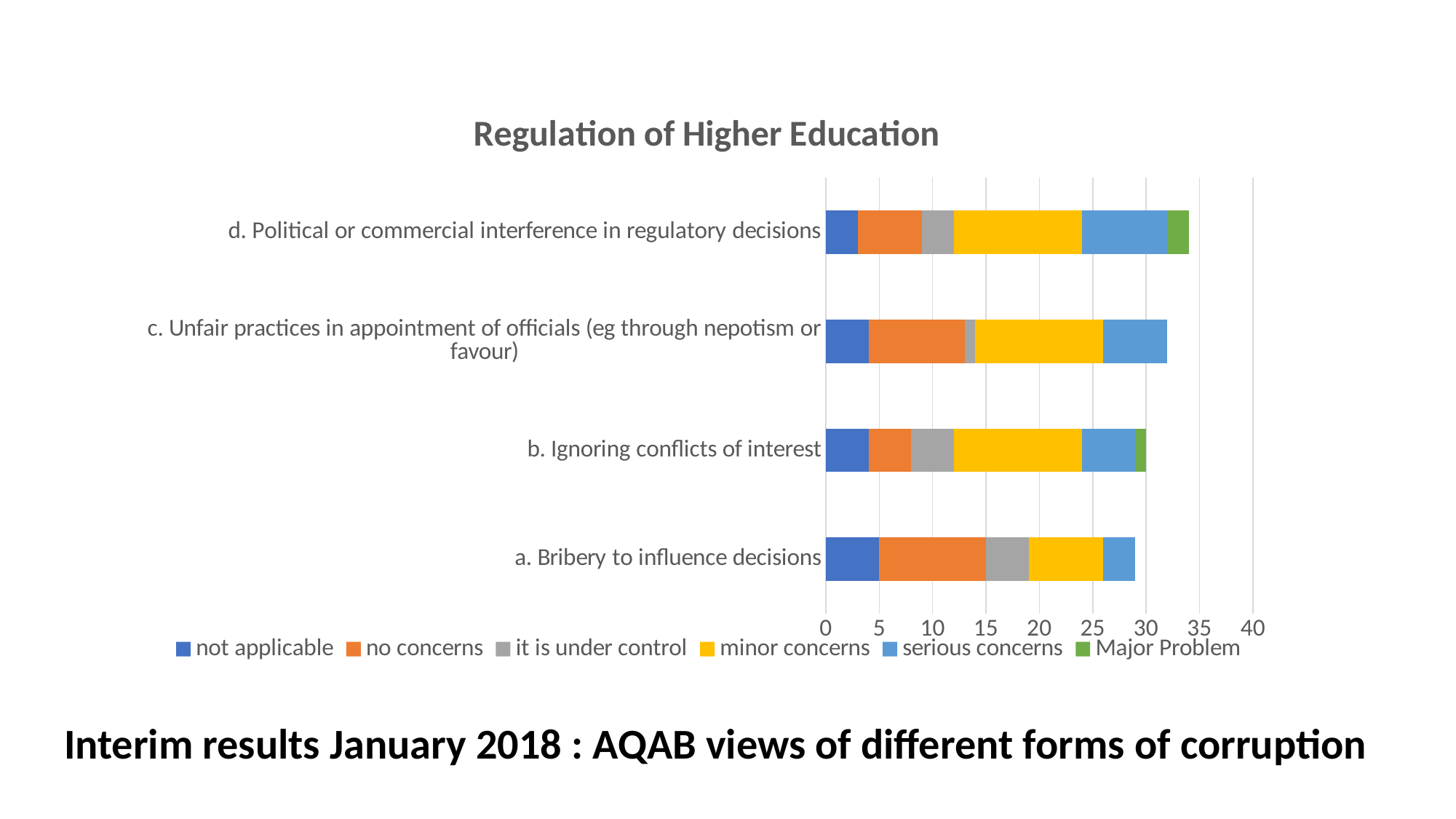
What is the title of the chart? Regulation of Higher Education How many categories (forms of corruption) are plotted on the chart? 4 How many series does the legend list? 6 Which category has the longest total stacked bar? d. Political or commercial interference in regulatory decisions Which category has the larger 'minor concerns' segment: 'a. Bribery to influence decisions' or 'd. Political or commercial interference in regulatory decisions'? d. Political or commercial interference in regulatory decisions What kind of chart is shown on the slide? stacked bar chart Is the total stacked bar for 'a. Bribery to influence decisions' greater or less than 25? greater Which colour represents 'serious concerns' in the legend? light blue How many categories show a 'Major Problem' segment? 2 Which category has the larger 'no concerns' segment: 'a. Bribery to influence decisions' or 'd. Political or commercial interference in regulatory decisions'? a. Bribery to influence decisions Is the total stacked bar for 'd. Political or commercial interference in regulatory decisions' greater or less than 30? greater Is the total stacked bar for 'b. Ignoring conflicts of interest' greater or less than 35? less